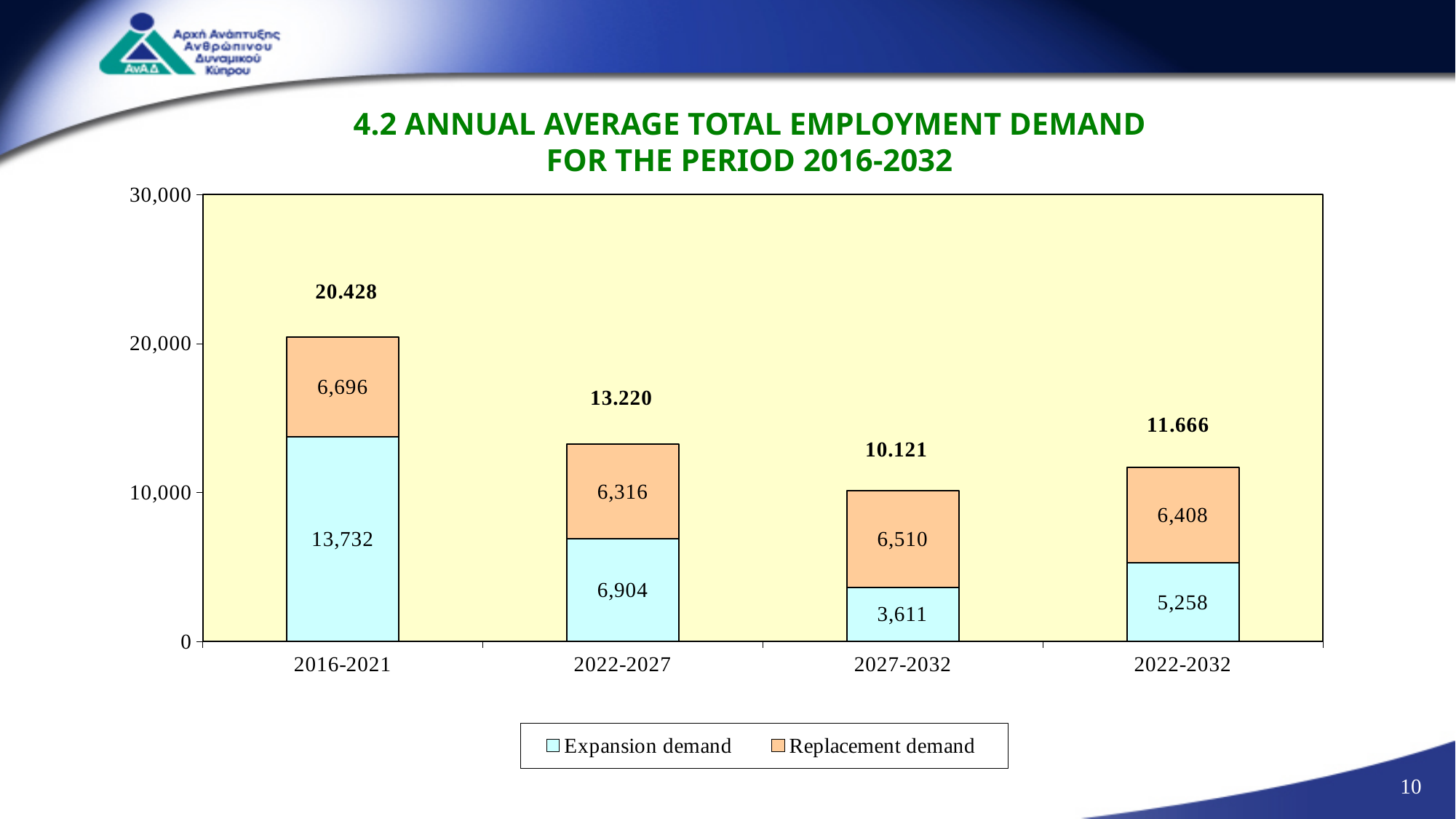
What is the Replacement demand value for 2027-2032? 6,510 What is the difference between Expansion demand and Replacement demand for 2016-2021? 7,036 What total is printed above the bar for 2022-2027? 13.220 What is the Expansion demand value for 2016-2021? 13,732 Which period has the highest total employment demand? 2016-2021 Is the total for 2022-2032 greater or less than 10,000? greater Which is larger for 2027-2032, Expansion demand or Replacement demand? Replacement demand What kind of chart is shown on the slide? Stacked bar chart Which period has the lowest Expansion demand? 2027-2032 How many series does the legend list? 2 How many periods are shown on the x axis? 4 What is the Expansion demand value for 2022-2032? 5,258